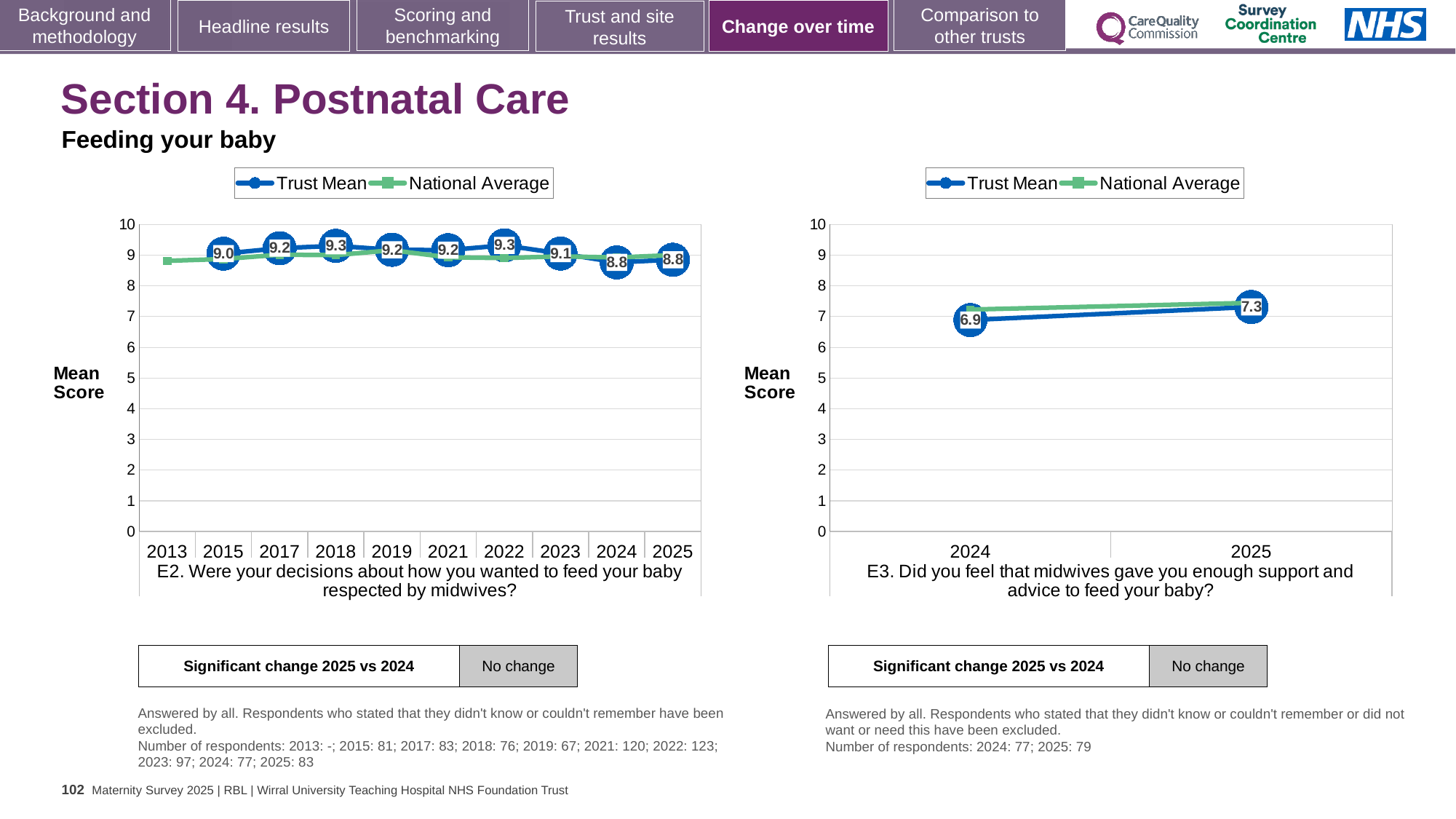
On the right chart (E3), is the National Average for 2025 greater or less than 7? greater On the left chart (E2), what is the highest Trust Mean value shown? 9.3 On the right chart (E3), does the Trust Mean rise or fall from 2024 to 2025? rise How many years are shown on the x axis of the left chart (E2)? 10 How many series does the legend of the left chart (E2) list? 2 On the right chart (E3), what is the Trust Mean for 2024? 6.9 On the left chart (E2), which year has the higher Trust Mean, 2022 or 2024? 2022 On the left chart (E2), what is the Trust Mean for 2025? 8.8 What type of chart is the left chart (E2)? line chart On the left chart (E2), what is the Trust Mean for 2018? 9.3 On the left chart (E2), what is the difference between the Trust Mean for 2023 and for 2024? 0.3 On the right chart (E3), what is the difference between the Trust Mean for 2025 and for 2024? 0.4